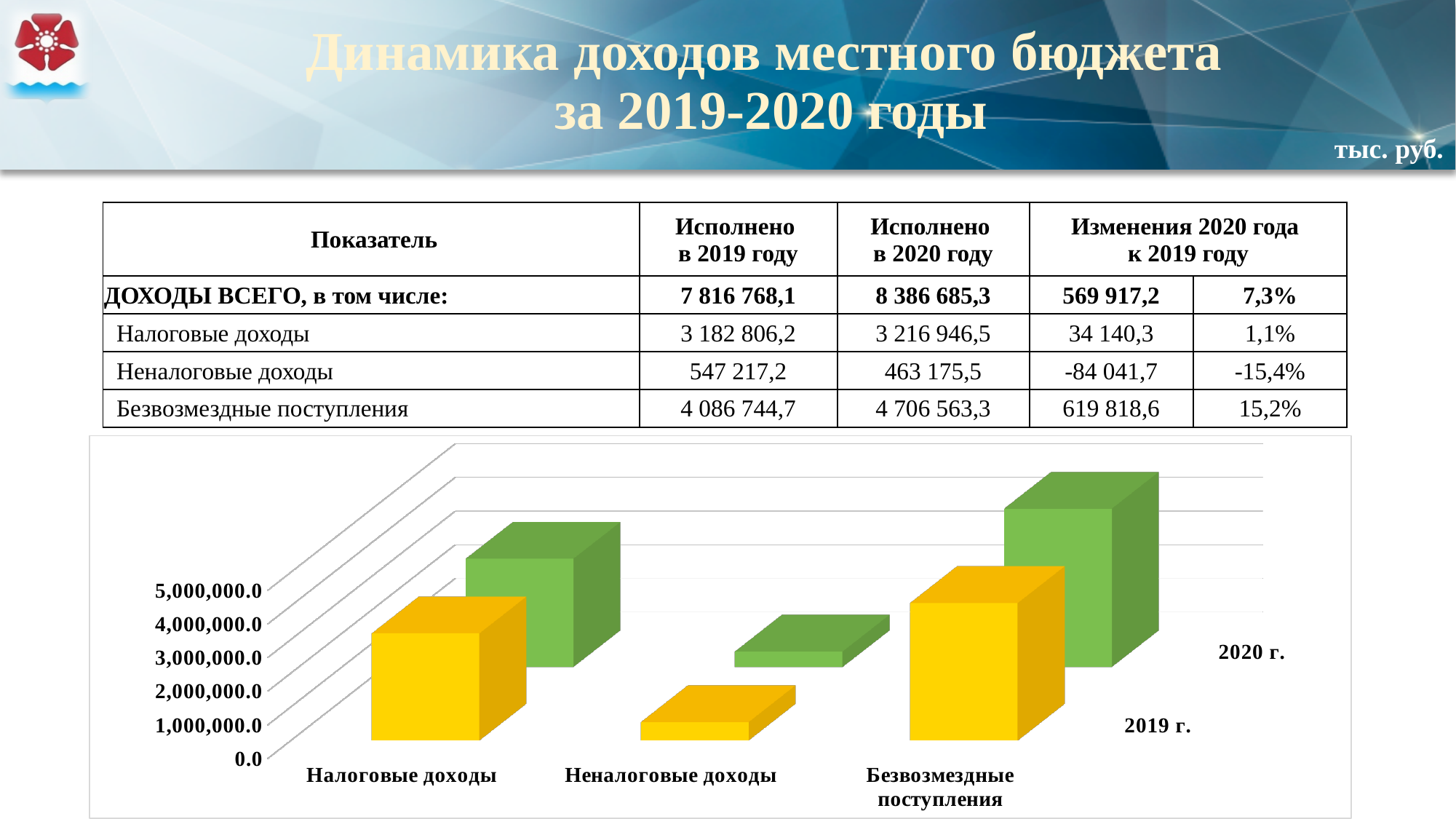
What kind of chart is shown on the slide? bar chart Which category has the tallest bar for 2020 г. in the chart? Безвозмездные поступления In the chart, which is larger for 2020 г.: Налоговые доходы or Безвозмездные поступления? Безвозмездные поступления In the chart, is the 2019 г. value for Неналоговые доходы greater or less than 1,000,000.0? less How many series does the chart show? 2 In the chart, is the 2020 г. value for Налоговые доходы greater or less than 2,000,000.0? greater Which category has the shortest bar for 2019 г. in the chart? Неналоговые доходы Which series is drawn in green in the chart? 2020 г. In the chart, is the 2020 г. value for Безвозмездные поступления greater or less than 4,000,000.0? greater According to the table on the slide, by how much did Неналоговые доходы change in 2020 compared to 2019? -84 041,7 According to the table on the slide, what was the value of Безвозмездные поступления executed in 2020? 4 706 563,3 How many categories are shown on the x axis of the chart? 3